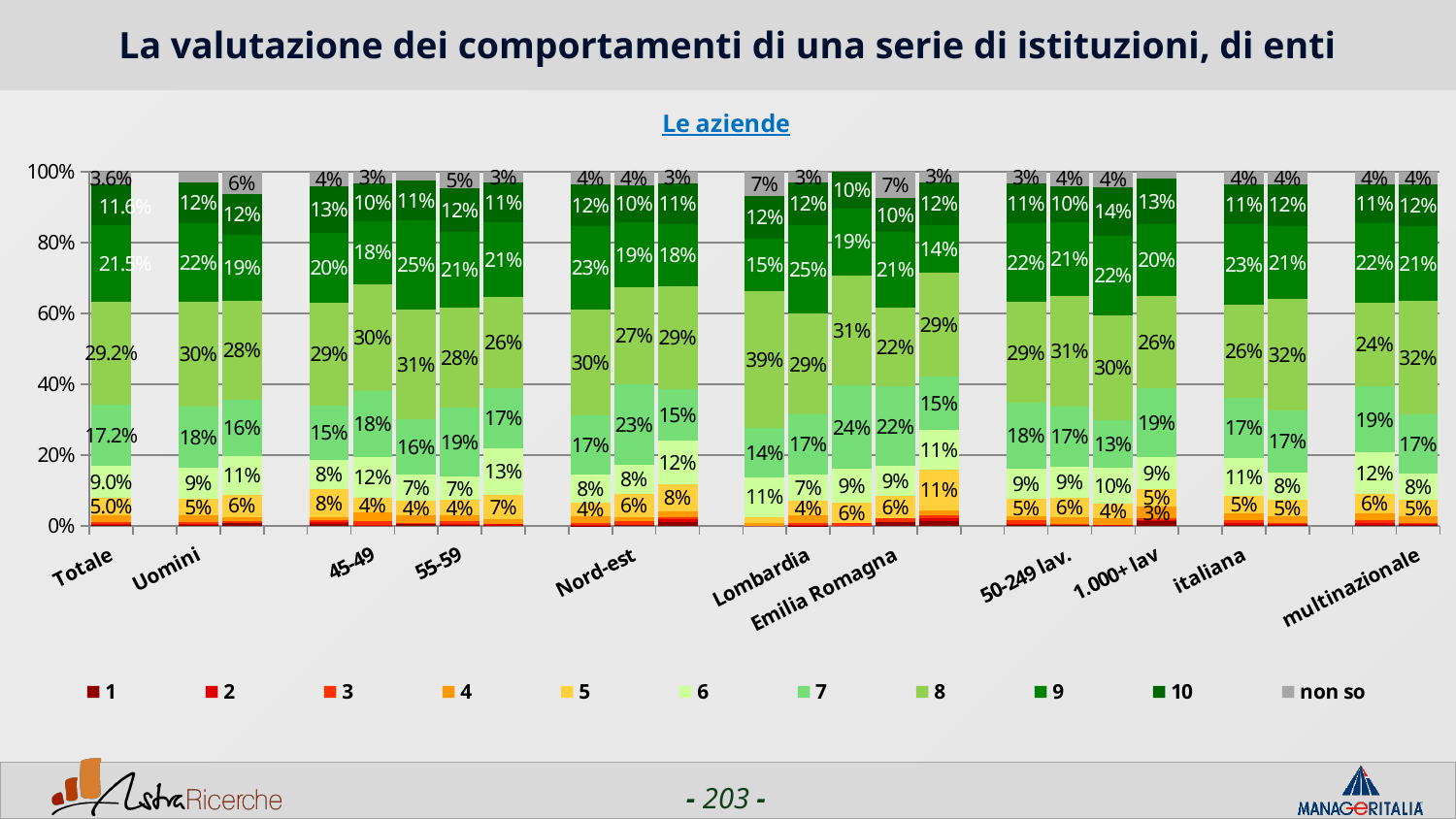
In the Totale bar, what is the difference between series 9 (21.5%) and series 10 (11.6%)? 9.9 percentage points In the Totale bar, which is larger: series 8 or series 7? 8 What kind of chart is shown on the slide? stacked bar chart What is the value of series 8 for the Uomini bar? 30% What is the subtitle shown above the chart? Le aziende How many series does the legend list? 11 What is the 'non so' value for the Totale bar? 3.6% What is the value of series 8 for the Totale bar? 29.2% What is the value of series 6 for the Totale bar? 9.0% What is the last entry in the legend? non so What is the value of series 5 for the Totale bar? 5.0% What is the value of series 10 for the Uomini bar? 12%